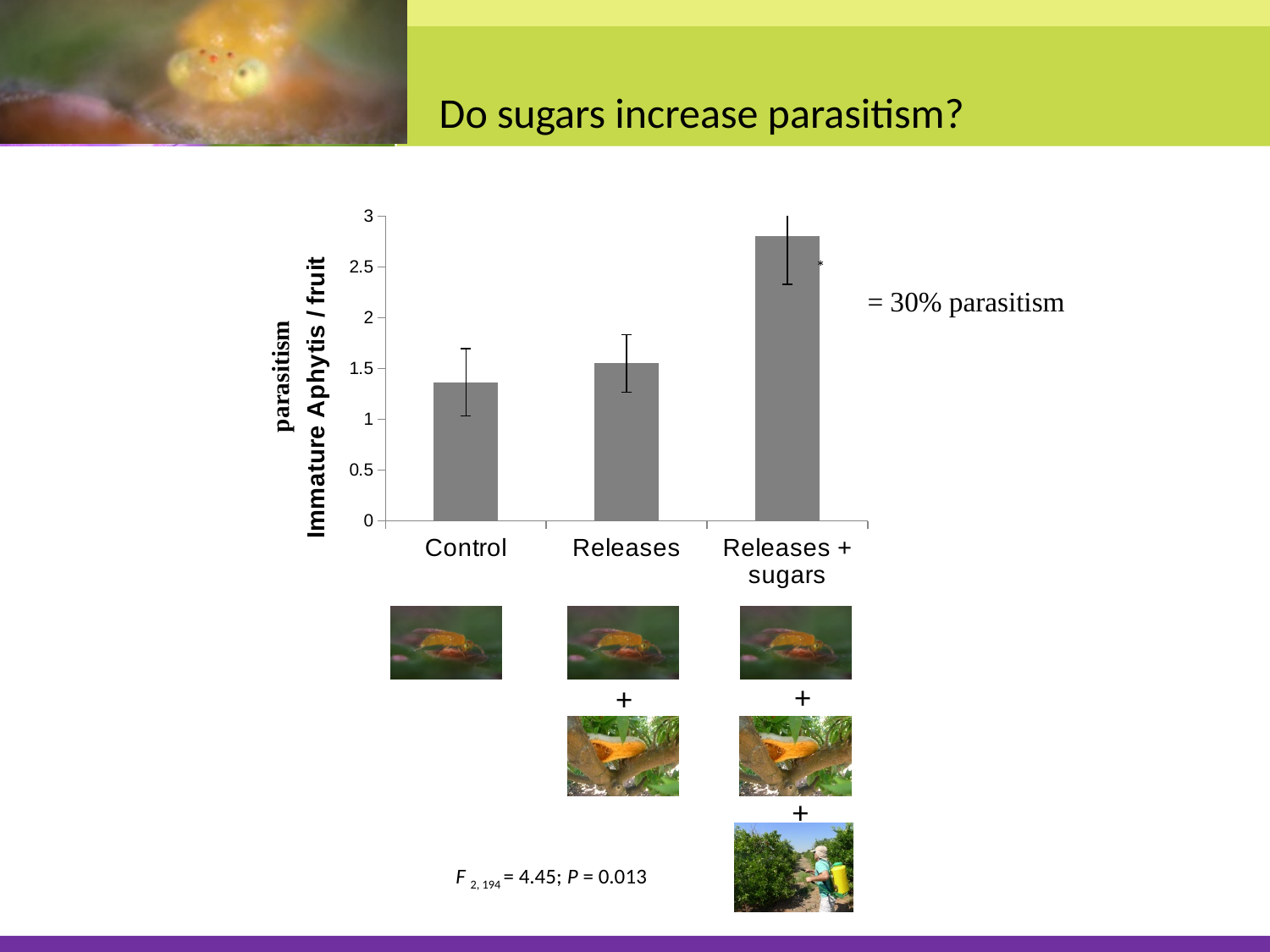
Is the value for Releases + sugars greater or less than 2.5? greater Which is larger, the value for Releases or the value for Releases + sugars? Releases + sugars Do the bar values rise or fall from Control to Releases + sugars along the x axis? rise What percentage of parasitism does the annotation next to the Releases + sugars bar state? 30% Is the value for Releases greater or less than 2? less Which category has the lowest value in the chart? Control Which is larger, the value for Control or the value for Releases? Releases What is the label on the y axis of the chart? Immature Aphytis / fruit Which category has the highest value in the chart? Releases + sugars What kind of chart is shown on the slide? bar chart Is the value for Control greater or less than 1? greater How many categories are shown on the x axis of the chart? 3